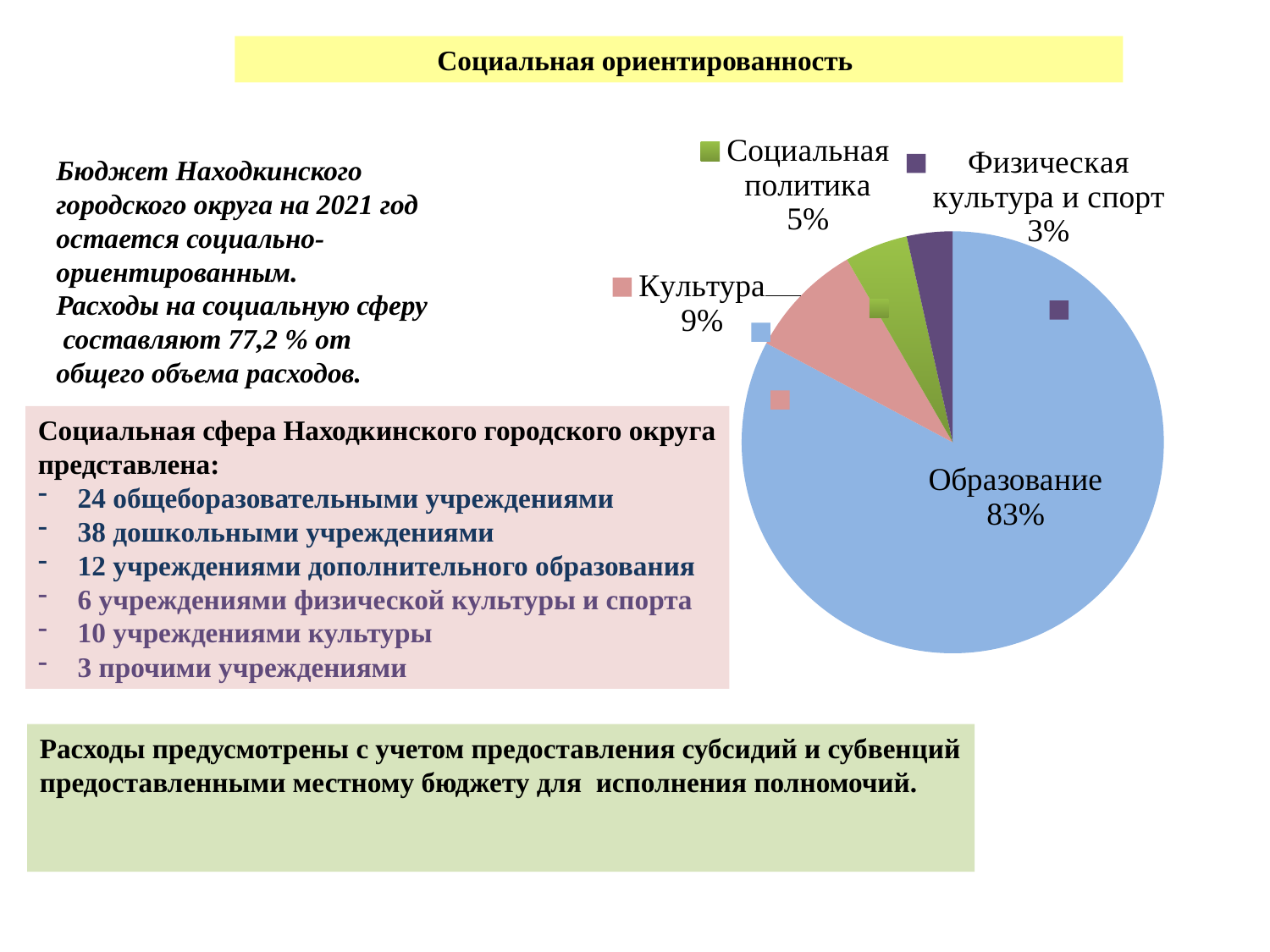
Which slice of the pie is the largest? Образование What share of the pie does Образование have? 83% What share of the pie does Культура have? 9% What colour is the Образование slice of the pie? Light blue What kind of chart is shown on the slide? Pie chart What share of the pie does Социальная политика have? 5% Which is larger, the share for Культура or the share for Социальная политика? Культура How many slices does the pie chart have? 4 What is the difference in percentage points between Образование and Культура? 74 Which slice of the pie is the smallest? Физическая культура и спорт What is the difference in percentage points between Социальная политика and Физическая культура и спорт? 2